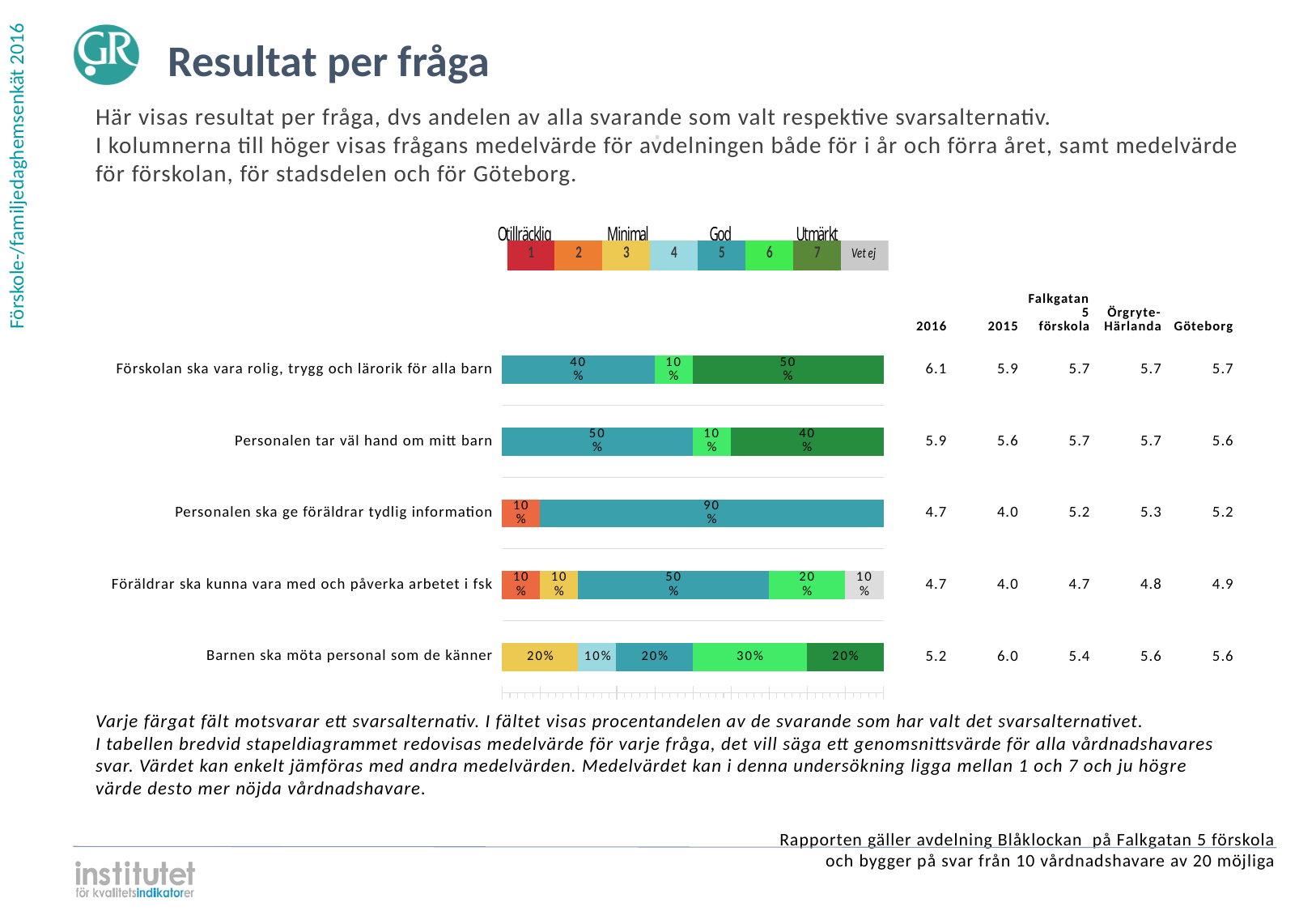
What percentage of respondents chose answer 7 (dark green) for "Förskolan ska vara rolig, trygg och lärorik för alla barn"? 50% For "Barnen ska möta personal som de känner", which is larger: the share choosing answer 3 or the share choosing answer 6? Answer 6 What percentage of respondents chose answer 6 (light green) for "Barnen ska möta personal som de känner"? 30% Which question has the largest single segment in its bar? Personalen ska ge föräldrar tydlig information For "Personalen tar väl hand om mitt barn", what is the difference between the share choosing answer 5 and the share choosing answer 7? 10% What are the four rating labels shown above the colour legend? Otillräcklig, Minimal, God, Utmärkt How many questions (categories) are plotted in the bar chart? 5 What percentage of respondents answered "Vet ej" for "Föräldrar ska kunna vara med och påverka arbetet i fsk"? 10% What is the 2016 mean value shown for "Förskolan ska vara rolig, trygg och lärorik för alla barn"? 6.1 What type of chart is shown on the slide? Stacked bar chart What is the Göteborg mean value shown for "Föräldrar ska kunna vara med och påverka arbetet i fsk"? 4.9 What percentage of respondents chose answer 5 (teal) for "Personalen ska ge föräldrar tydlig information"? 90%